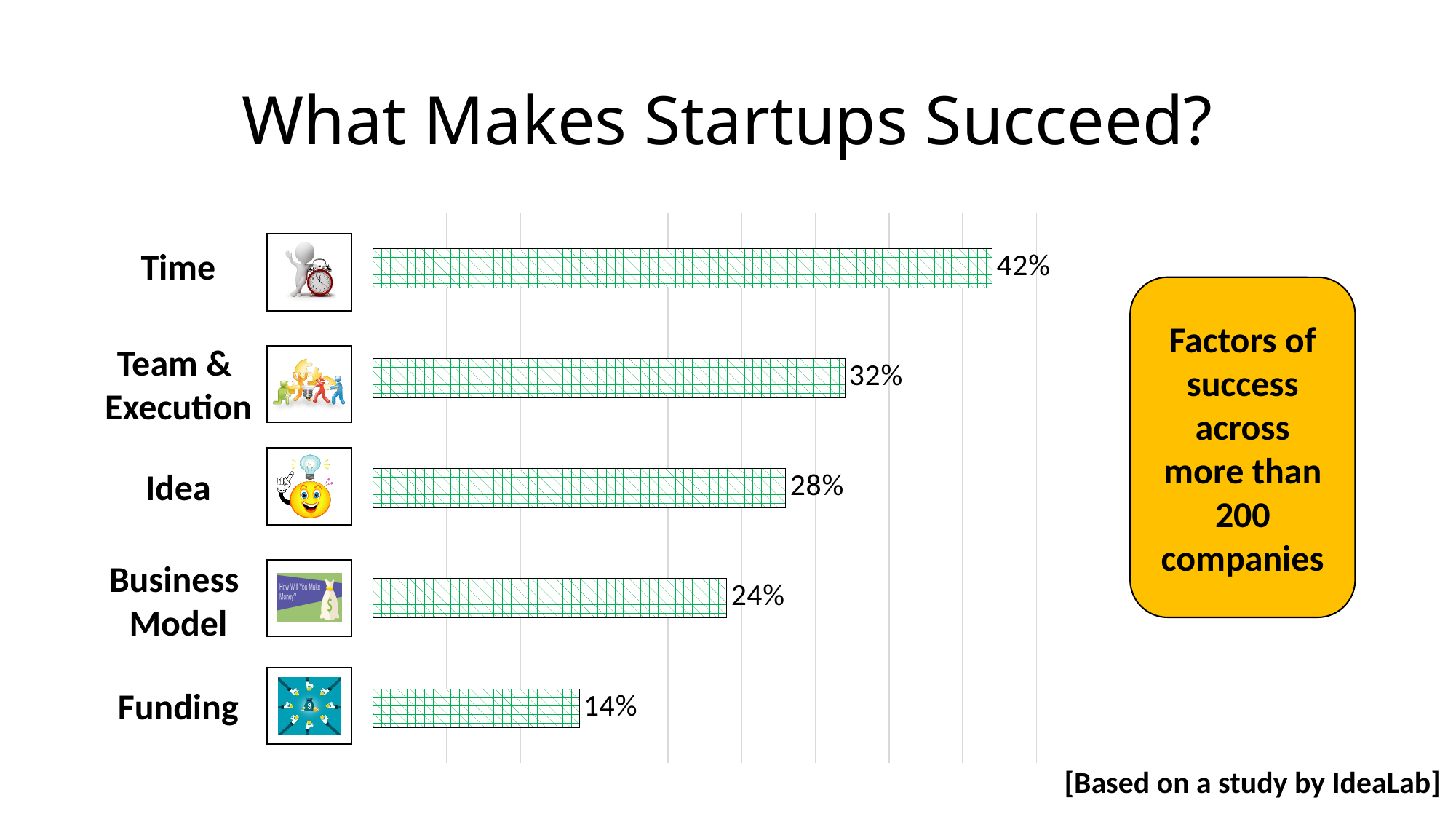
What is the value for Funding? 14% Which factor has the highest value? Time What is the value for Time? 42% Which factor has the lowest value? Funding Which is larger, the value for Idea or the value for Business Model? Idea What is the value for Business Model? 24% What is the difference between the values for Team & Execution and Idea? 4% What is the value for Team & Execution? 32% What is the difference between the values for Time and Funding? 28% How many factors are shown in the chart? 5 What kind of chart is shown on the slide? Bar chart What is the value for Idea? 28%